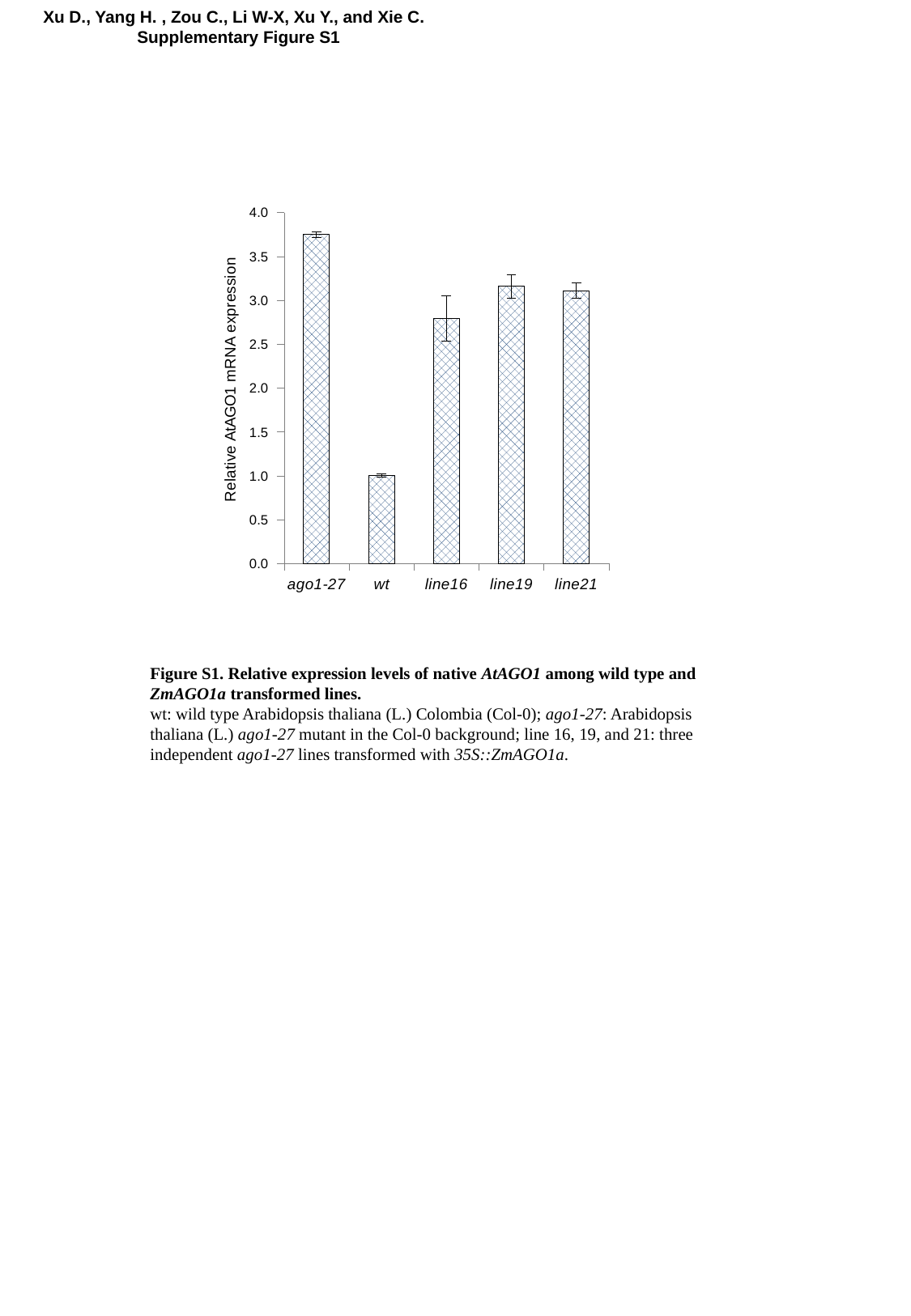
Is the value for line16 greater or less than 3.0? less Is the value for ago1-27 greater or less than 3.5? greater Is the value for line19 greater or less than 3.0? greater Which has a higher relative AtAGO1 mRNA expression, line16 or line19? line19 Which category has the highest relative AtAGO1 mRNA expression? ago1-27 What is the label of the y axis of the chart? Relative AtAGO1 mRNA expression What is the relative AtAGO1 mRNA expression value for wt? 1.0 What kind of chart is shown on the slide? bar chart Which has a higher relative AtAGO1 mRNA expression, ago1-27 or wt? ago1-27 Which category has the lowest relative AtAGO1 mRNA expression? wt How many categories are plotted on the x axis of the chart? 5